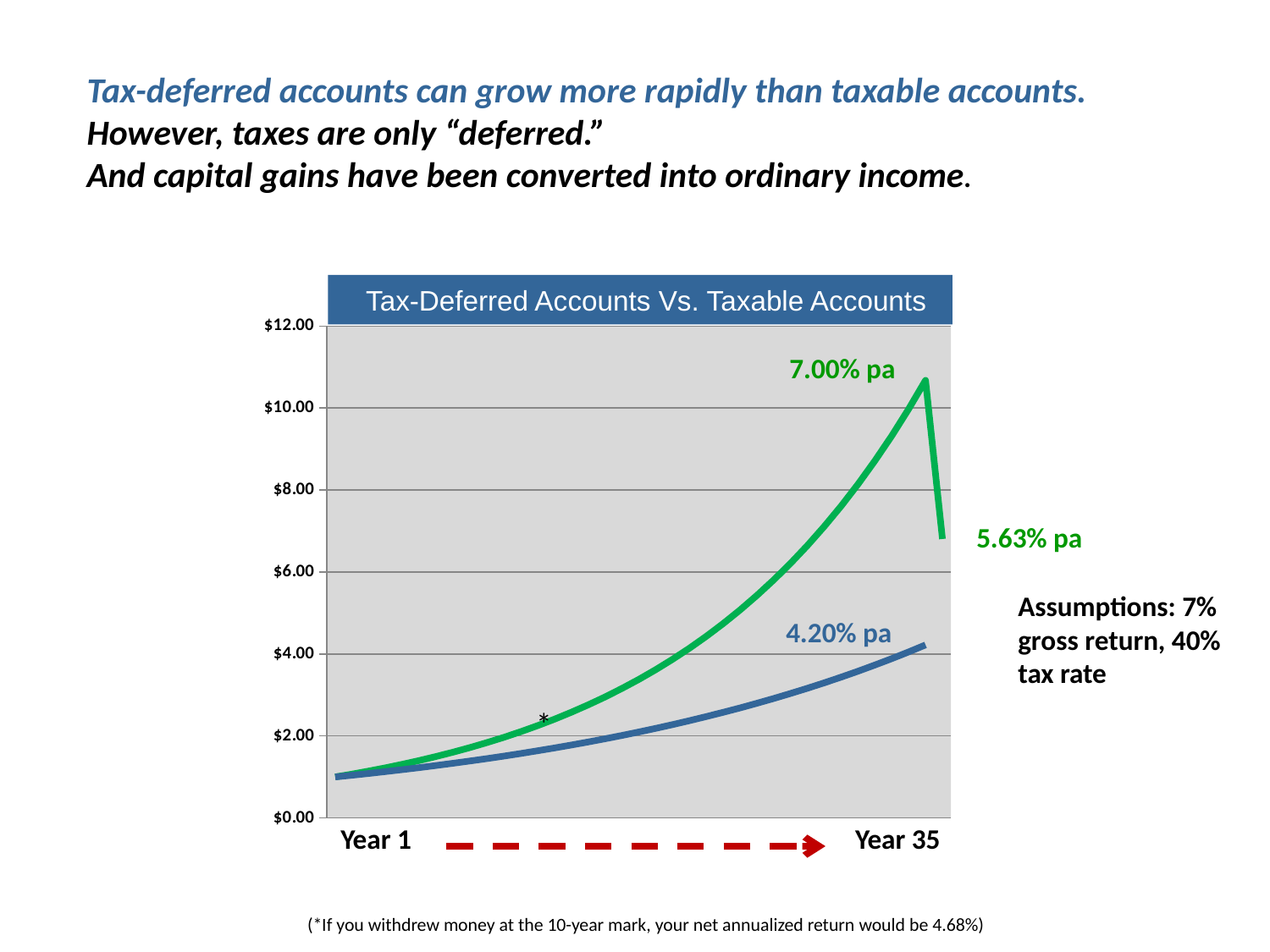
What is the highest value shown on the vertical axis? $12.00 What is the title of the chart? Tax-Deferred Accounts Vs. Taxable Accounts Is the value of the blue line at Year 35 greater or less than $6.00? less How many lines are plotted on the chart? 2 What kind of chart is shown on the slide? line chart What annual rate is labelled on the green line? 7.00% pa Is the value of the green line at Year 1 greater or less than $2.00? less Is the value of the green line after its final drop greater or less than $6.00? greater Which line reaches a higher value by Year 35, the green line or the blue line? the green line Does the blue line rise or fall from Year 1 to Year 35? rise